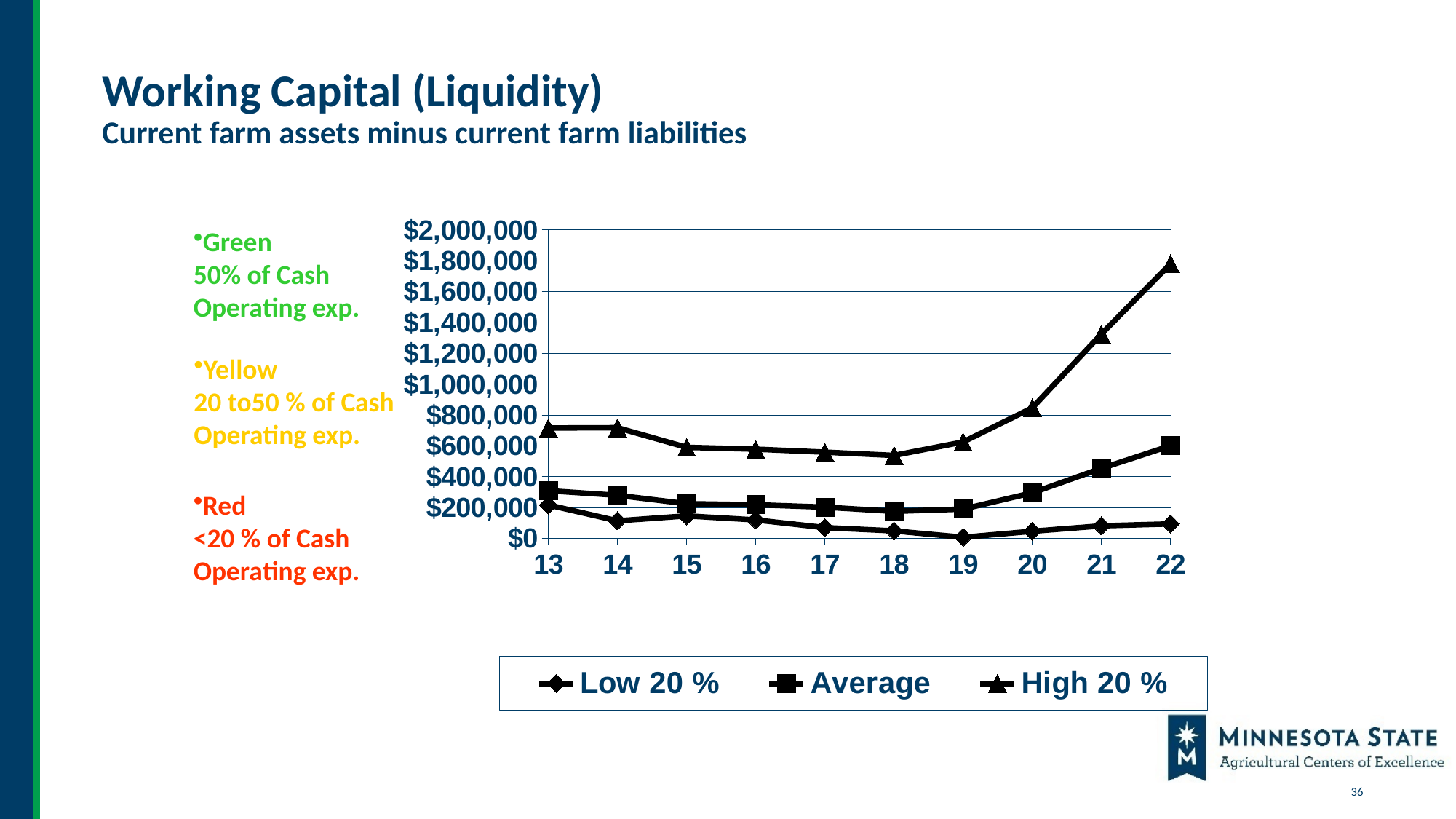
Does the High 20 % series rise or fall from year 19 to year 22? rises Is the High 20 % value for year 22 greater or less than $1,600,000? greater Which series is marked with triangle markers in the legend? High 20 % Is the High 20 % value for year 13 greater or less than $800,000? less In which year does the High 20 % series reach its highest value? 22 How many series does the legend list? 3 Is the Average value for year 21 greater or less than $400,000? greater How many years are shown along the x axis? 10 Which is larger for the Average series: the value in year 13 or the value in year 18? year 13 What kind of chart is shown on the slide? line chart In which year does the Low 20 % series reach its lowest value? 19